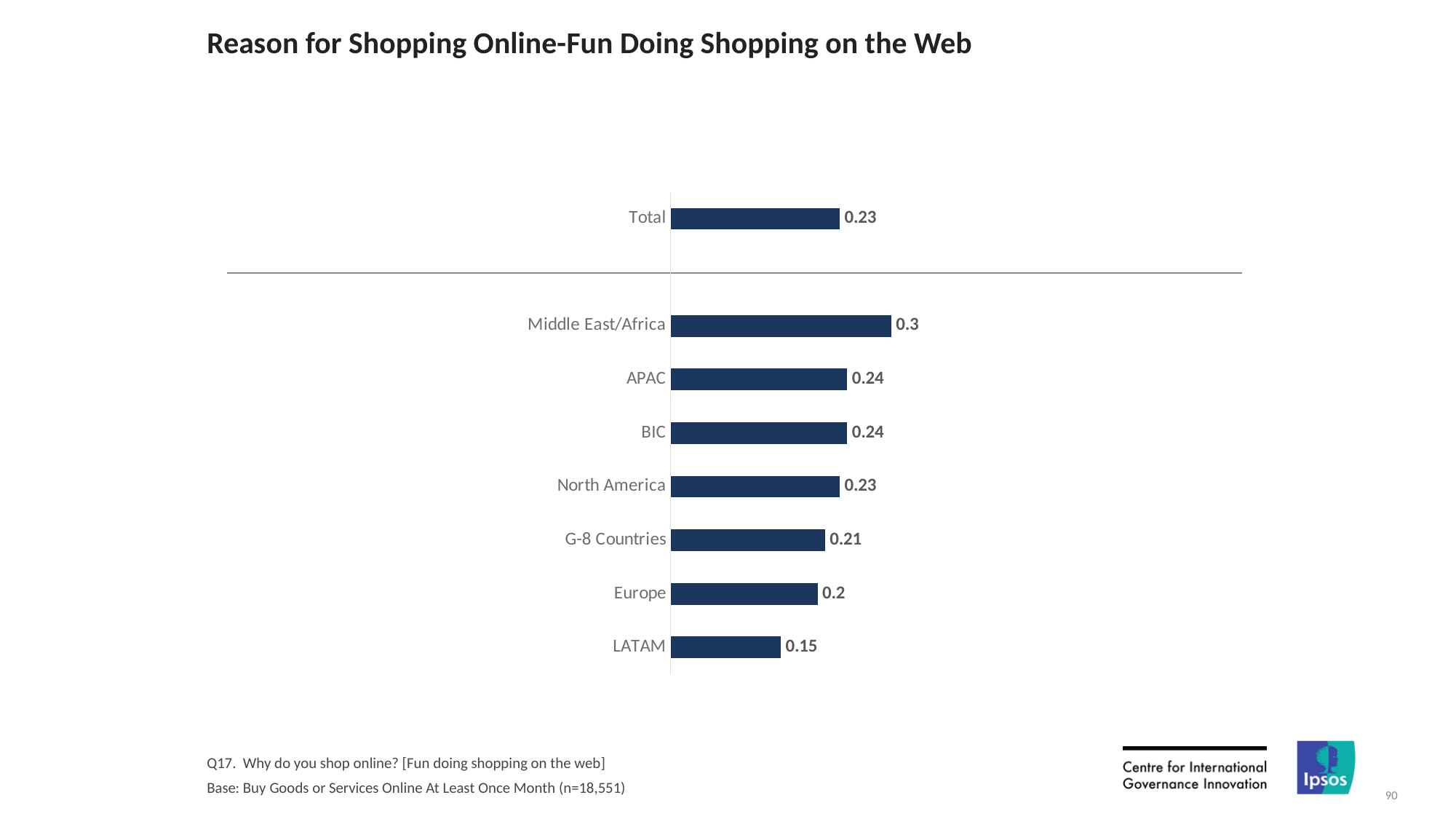
What is the value for Total? 0.23 How many bars are shown in the chart? 8 What is the value for Europe? 0.2 What is the value for LATAM? 0.15 What is the title of the chart? Reason for Shopping Online-Fun Doing Shopping on the Web Which region has the lowest value? LATAM What is the value for Middle East/Africa? 0.3 What kind of chart is shown on the slide? Bar chart Which region has the highest value? Middle East/Africa Which is larger, the value for G-8 Countries or the value for North America? North America What is the difference between the values for APAC and Europe? 0.04 What is the difference between the values for Middle East/Africa and LATAM? 0.15